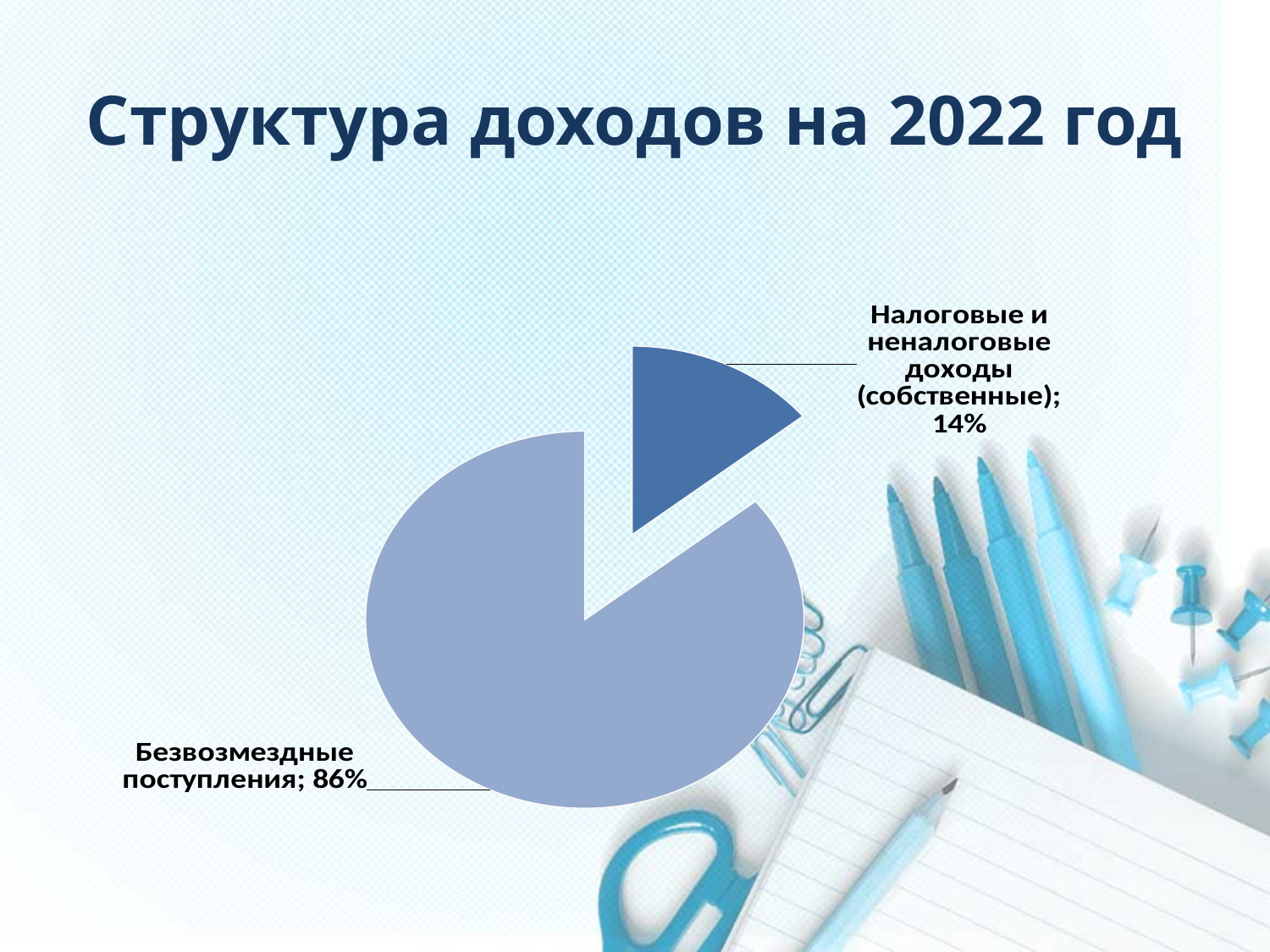
Which slice is pulled out (exploded) from the pie? Налоговые и неналоговые доходы (собственные) What share of the pie is labelled 'Налоговые и неналоговые доходы (собственные)'? 14% What kind of chart is shown on the slide? Pie chart What share of the pie is labelled 'Безвозмездные поступления'? 86% Which is larger: the share for 'Безвозмездные поступления' or for 'Налоговые и неналоговые доходы (собственные)'? Безвозмездные поступления What is the difference in percentage points between 'Безвозмездные поступления' and 'Налоговые и неналоговые доходы (собственные)'? 72 What is the title of the slide containing the pie chart? Структура доходов на 2022 год How many slices does the pie chart have? 2 Which category has the largest slice of the pie? Безвозмездные поступления Which category has the smallest slice of the pie? Налоговые и неналоговые доходы (собственные)